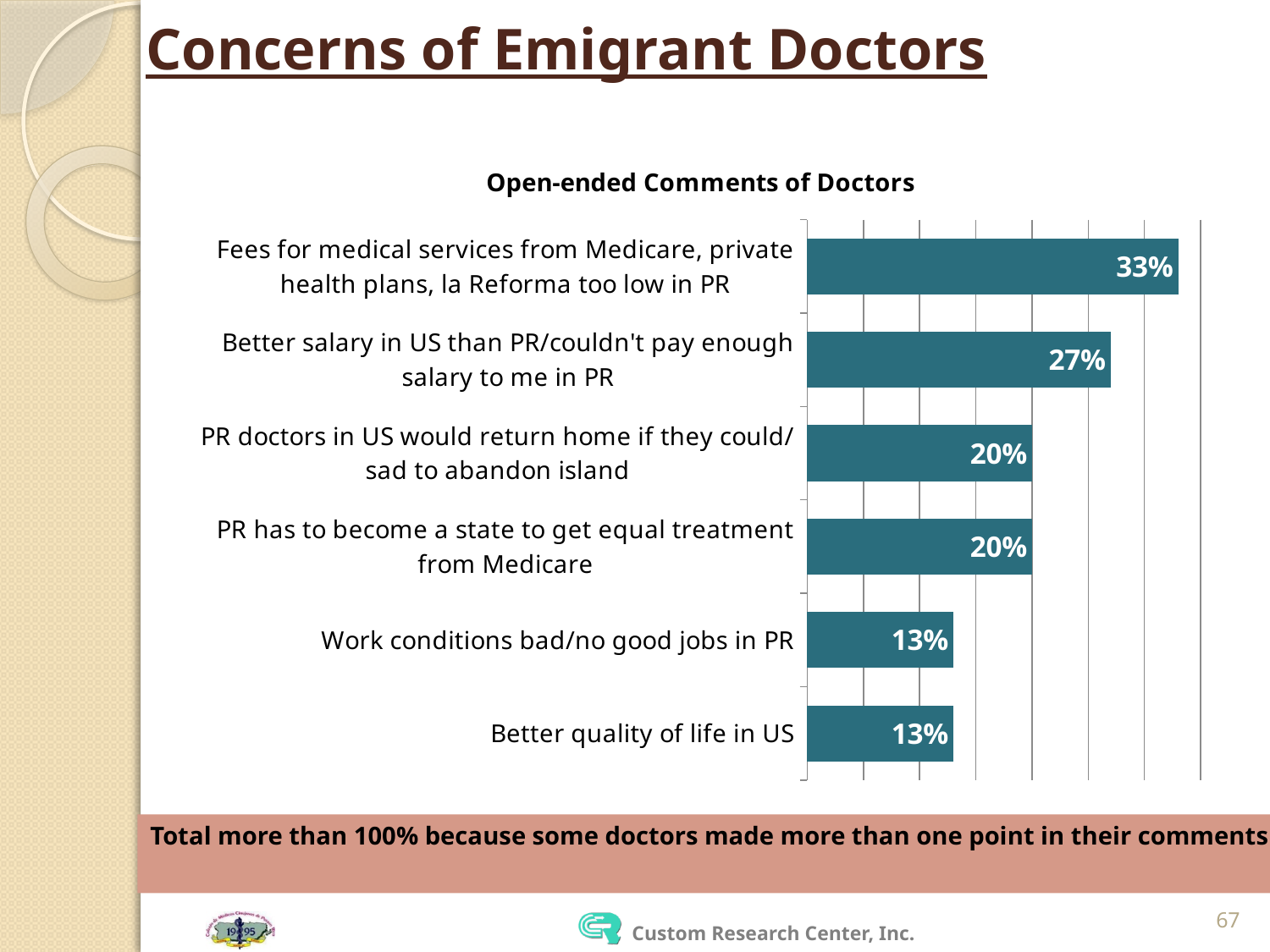
What is the value for 'Better salary in US than PR/couldn't pay enough salary to me in PR'? 27% What kind of chart is shown on the slide? Bar chart What is the difference between the value for 'Better salary in US than PR' and the value for 'Better quality of life in US'? 14% What is the title of the chart? Open-ended Comments of Doctors Which is larger: the value for 'PR doctors in US would return home if they could' or the value for 'Work conditions bad/no good jobs in PR'? PR doctors in US would return home if they could/sad to abandon island Which concern has the highest percentage? Fees for medical services from Medicare, private health plans, la Reforma too low in PR What is the value for 'PR has to become a state to get equal treatment from Medicare'? 20% What is the difference between the value for 'Fees for medical services ... too low in PR' and the value for 'Better salary in US than PR'? 6% Why does the total exceed 100%, according to the note on the slide? Some doctors made more than one point in their comments What percentage is shown for 'Work conditions bad/no good jobs in PR'? 13% How many categories (concerns) are shown in the chart? 6 What percentage of doctors commented that fees for medical services from Medicare, private health plans, la Reforma are too low in PR? 33%